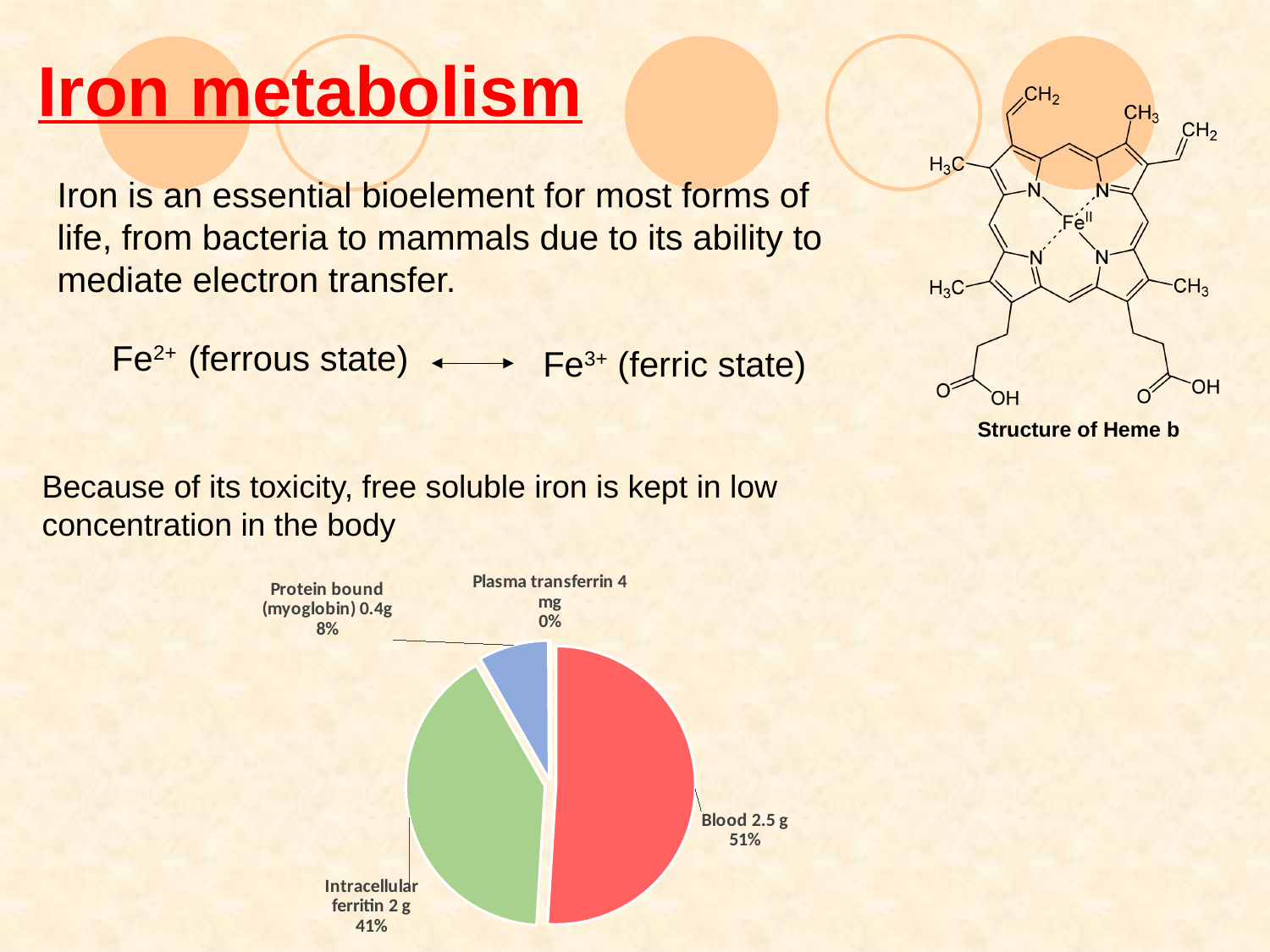
What amount of iron is shown in the label for Plasma transferrin in the pie chart? 4 mg In the pie chart, what is the difference in percentage between Blood and Intracellular ferritin? 10% What percentage of the pie chart is labelled for Plasma transferrin? 0% Which slice of the pie chart is the smallest? Plasma transferrin 4 mg What percentage of the pie chart is labelled for Blood? 51% What percentage of the pie chart is labelled for Protein bound (myoglobin)? 8% What amount of iron is shown in the label for Intracellular ferritin in the pie chart? 2 g What kind of chart is shown at the bottom of the slide? pie chart Which slice of the pie chart is the largest? Blood 2.5 g How many slices does the pie chart have? 4 What amount of iron is shown in the label for Blood in the pie chart? 2.5 g